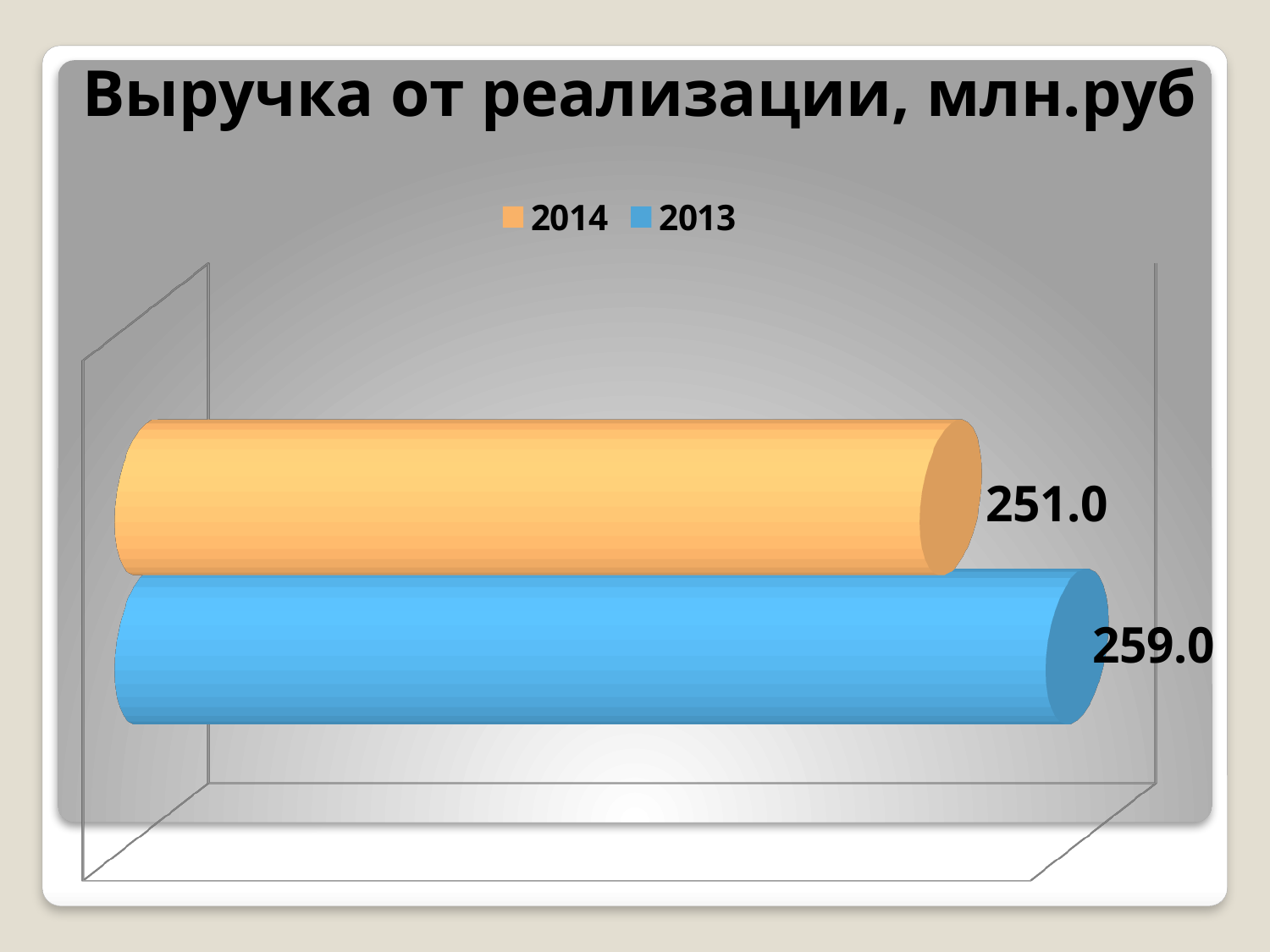
What is the title of the chart? Выручка от реализации, млн.руб What kind of chart is shown? bar chart Which series has the highest value? 2013 What is the value for 2013? 259.0 Did revenue rise or fall from 2013 to 2014? fall What colour is the bar for 2013? blue What is the difference between the 2013 and 2014 values? 8.0 How many series does the legend list? 2 How many bars are plotted on the chart? 2 Which series has the lowest value? 2014 What is the value for 2014? 251.0 Which year has the higher revenue, 2013 or 2014? 2013